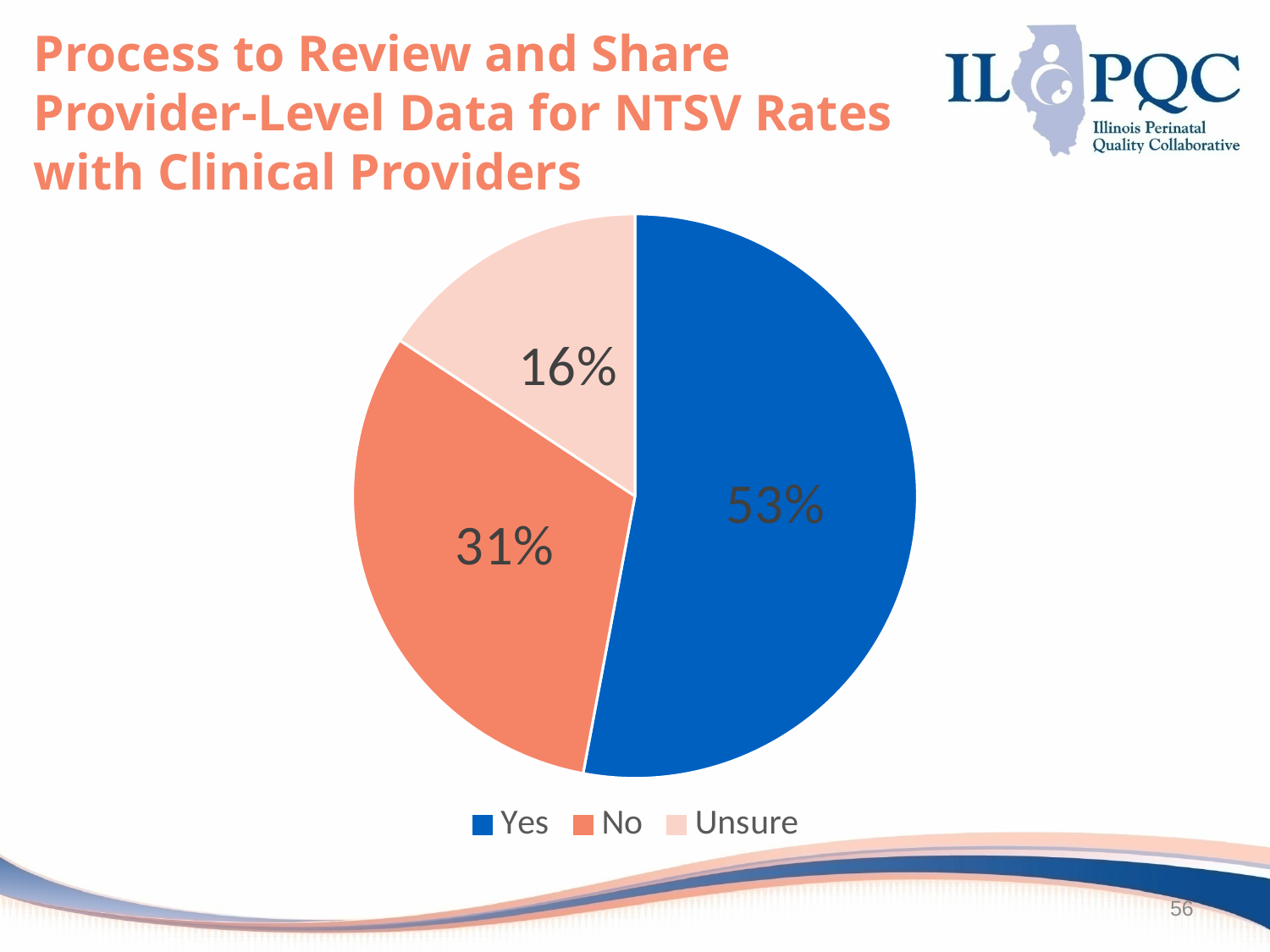
What kind of chart is shown on the slide? Pie chart What colour is the "Yes" slice? Blue Which slice is larger, "No" or "Unsure"? No What is the difference in percentage points between the "Yes" and "No" slices? 22 What is the difference in percentage points between the "No" and "Unsure" slices? 15 How many categories does the pie chart have? 3 What share of the pie is labelled "Yes"? 53% What are the legend entries listed below the pie chart? Yes, No, Unsure What share of the pie is labelled "Unsure"? 16% What share of the pie is labelled "No"? 31% Which category has the smallest slice of the pie? Unsure Which category has the largest slice of the pie? Yes